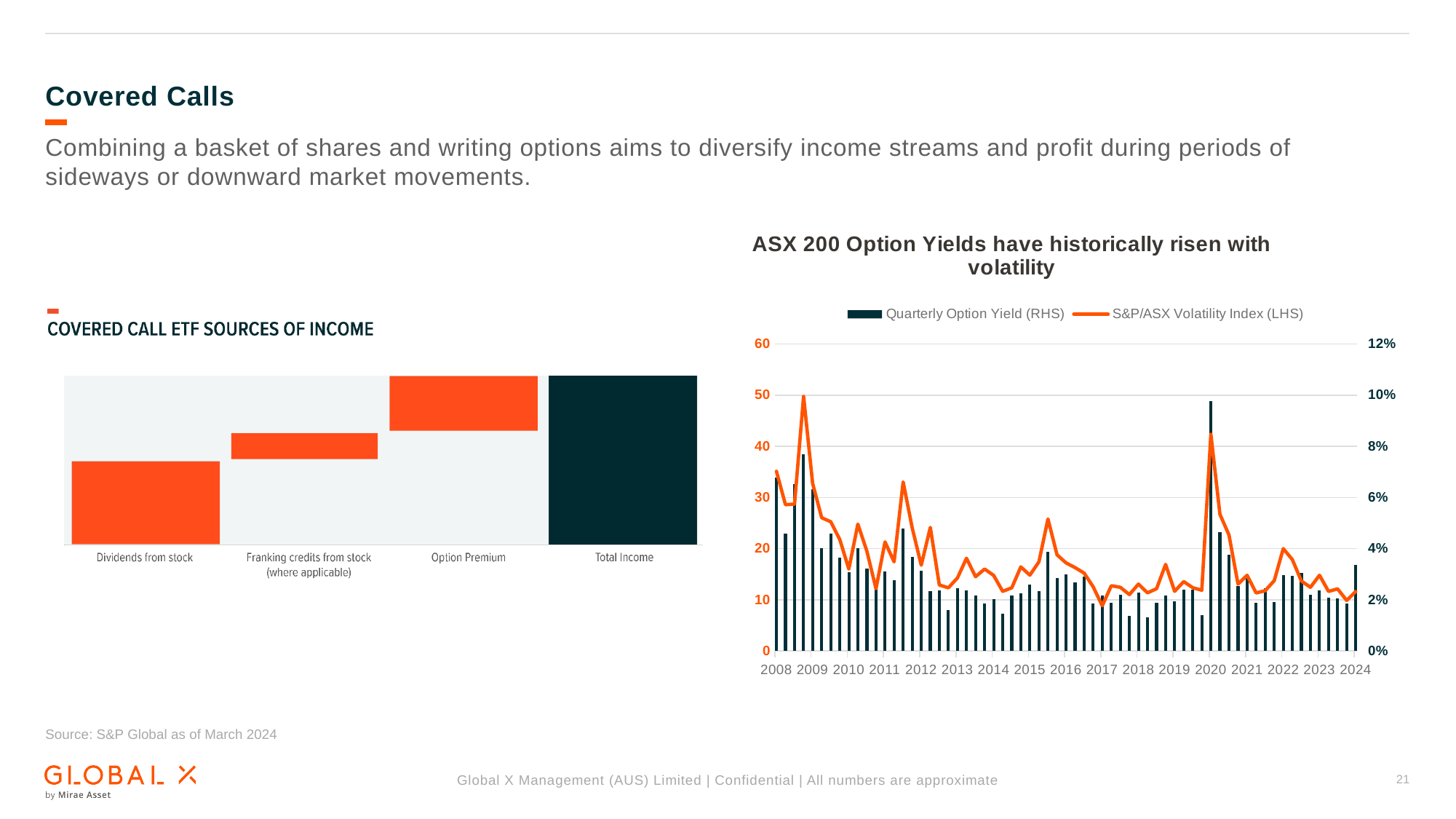
How many series does the legend list in the 'ASX 200 Option Yields have historically risen with volatility' chart? 2 In the 'ASX 200 Option Yields have historically risen with volatility' chart, is the S&P/ASX Volatility Index at the end of 2024 greater or less than 20? less How many categories are shown on the x axis of the 'COVERED CALL ETF SOURCES OF INCOME' chart? 4 In the 'ASX 200 Option Yields have historically risen with volatility' chart, which series is drawn as a line? S&P/ASX Volatility Index (LHS) What kind of chart is the 'COVERED CALL ETF SOURCES OF INCOME' chart on the left? bar chart What is the maximum value shown on the right-hand axis of the 'ASX 200 Option Yields have historically risen with volatility' chart? 12% In the 'COVERED CALL ETF SOURCES OF INCOME' chart, which segment is larger: Dividends from stock or Option Premium? Dividends from stock In the 'COVERED CALL ETF SOURCES OF INCOME' chart, which income source has the smallest segment? Franking credits from stock (where applicable) In the 'ASX 200 Option Yields have historically risen with volatility' chart, is the peak of the S&P/ASX Volatility Index around 2008-2009 greater or less than 40? greater In the 'COVERED CALL ETF SOURCES OF INCOME' chart, which category has the tallest bar? Total Income In the 'ASX 200 Option Yields have historically risen with volatility' chart, in which year does the Quarterly Option Yield reach its highest bar? 2020 In the 'ASX 200 Option Yields have historically risen with volatility' chart, is the highest Quarterly Option Yield bar in 2020 greater or less than 8%? greater